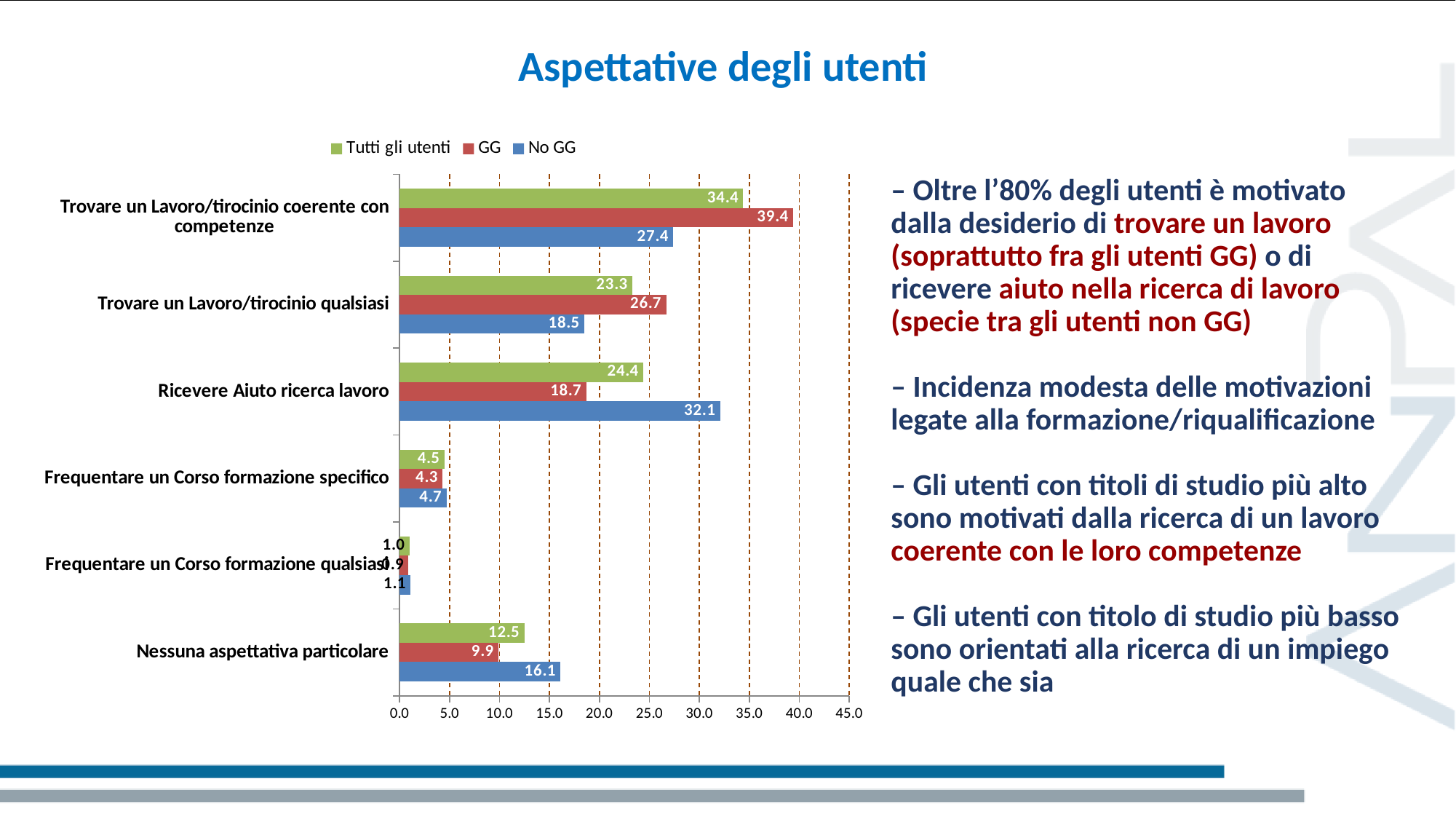
What kind of chart is shown on the slide? bar chart For 'Ricevere Aiuto ricerca lavoro', which is larger: the GG value or the No GG value? No GG Which category has the lowest value for the No GG series? Frequentare un Corso formazione qualsiasi Which series is shown in green in the legend? Tutti gli utenti What is the 'Tutti gli utenti' value for 'Nessuna aspettativa particolare'? 12.5 How many categories are shown on the chart? 6 What is the difference between the GG and No GG values for 'Trovare un Lavoro/tirocinio coerente con competenze'? 12.0 What is the No GG value for 'Ricevere Aiuto ricerca lavoro'? 32.1 What is the GG value for 'Trovare un Lavoro/tirocinio coerente con competenze'? 39.4 What is the difference between the No GG and GG values for 'Nessuna aspettativa particolare'? 6.2 How many series does the legend list? 3 Which category has the highest value for the GG series? Trovare un Lavoro/tirocinio coerente con competenze